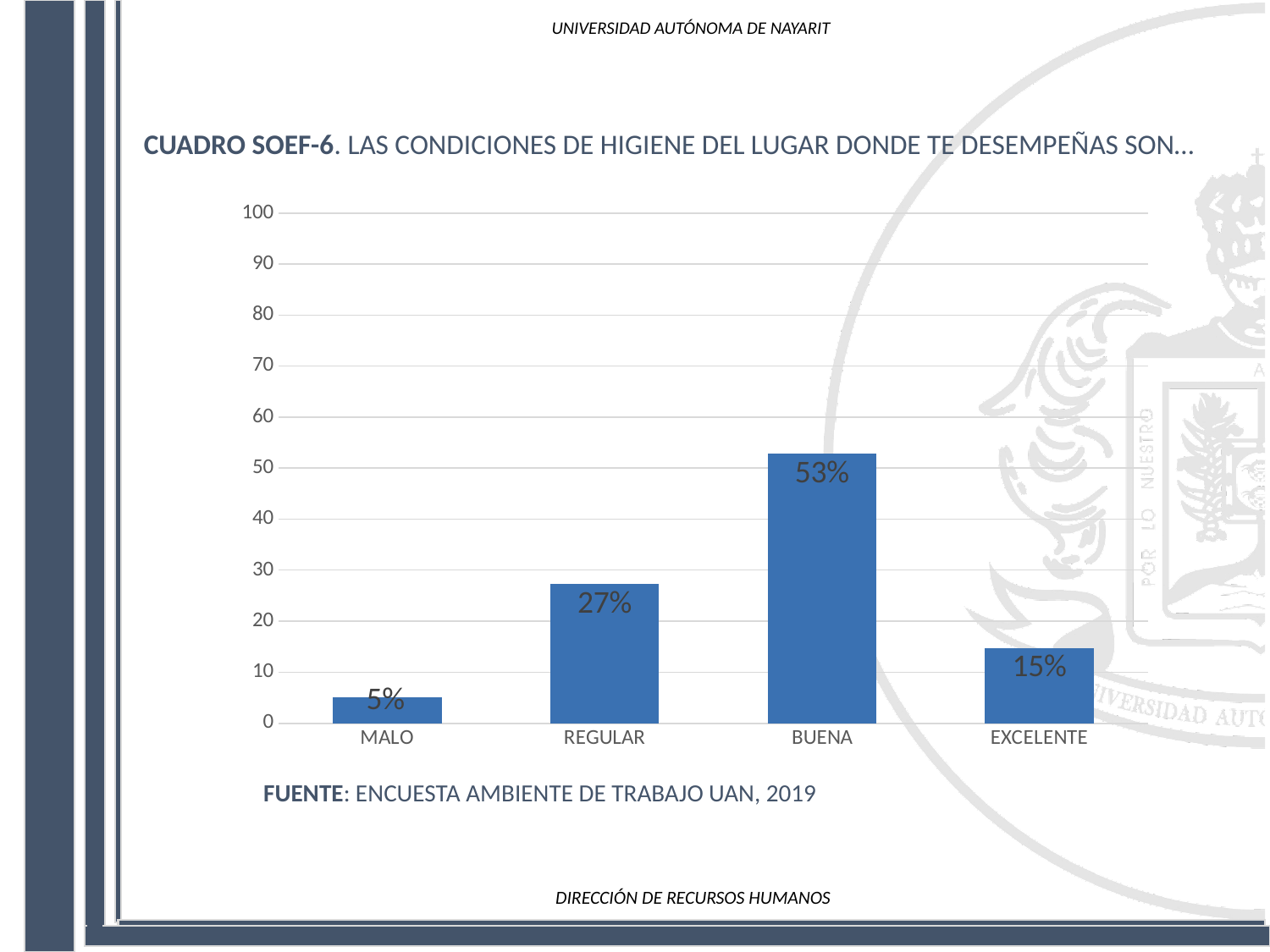
Which category has the highest value? BUENA Which is larger, the value for REGULAR or the value for EXCELENTE? REGULAR Which category has the lowest value? MALO What is the value for REGULAR? 27% What is the difference between the values for BUENA and REGULAR? 26% What is the value for EXCELENTE? 15% What is the value for BUENA? 53% Is the value for BUENA greater or less than 50? greater What kind of chart is shown on the slide? bar chart What is the value for MALO? 5% What source is cited below the chart? ENCUESTA AMBIENTE DE TRABAJO UAN, 2019 How many categories are shown on the x axis? 4